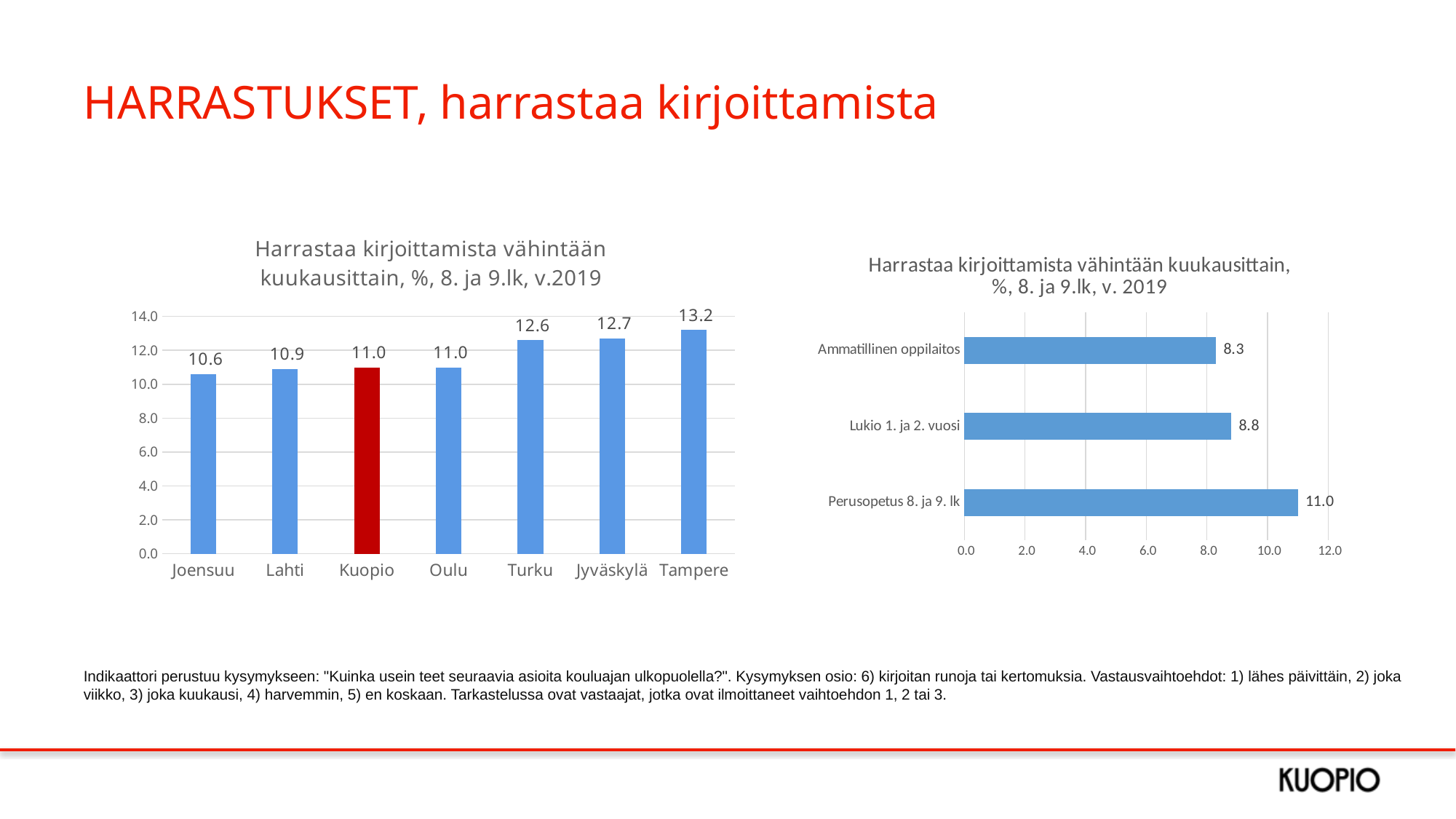
In the left chart (cities), which bar is coloured red instead of blue? Kuopio In the left chart (cities), what is the value for Kuopio? 11.0 In the left chart (cities), which city has the lowest value? Joensuu In the left chart (cities), which city has the highest value? Tampere In the right chart (school types), what is the difference between Perusopetus 8. ja 9. lk and Ammatillinen oppilaitos? 2.7 In the left chart (cities), what is the difference between Tampere and Joensuu? 2.6 In the right chart (school types), what is the value for Lukio 1. ja 2. vuosi? 8.8 In the right chart (school types), how many categories are shown? 3 In the left chart (cities), which is larger, the value for Turku or the value for Lahti? Turku In the left chart (cities), how many cities are shown? 7 What type of chart is the right chart (school types)? Bar chart In the right chart (school types), which category has the highest value? Perusopetus 8. ja 9. lk